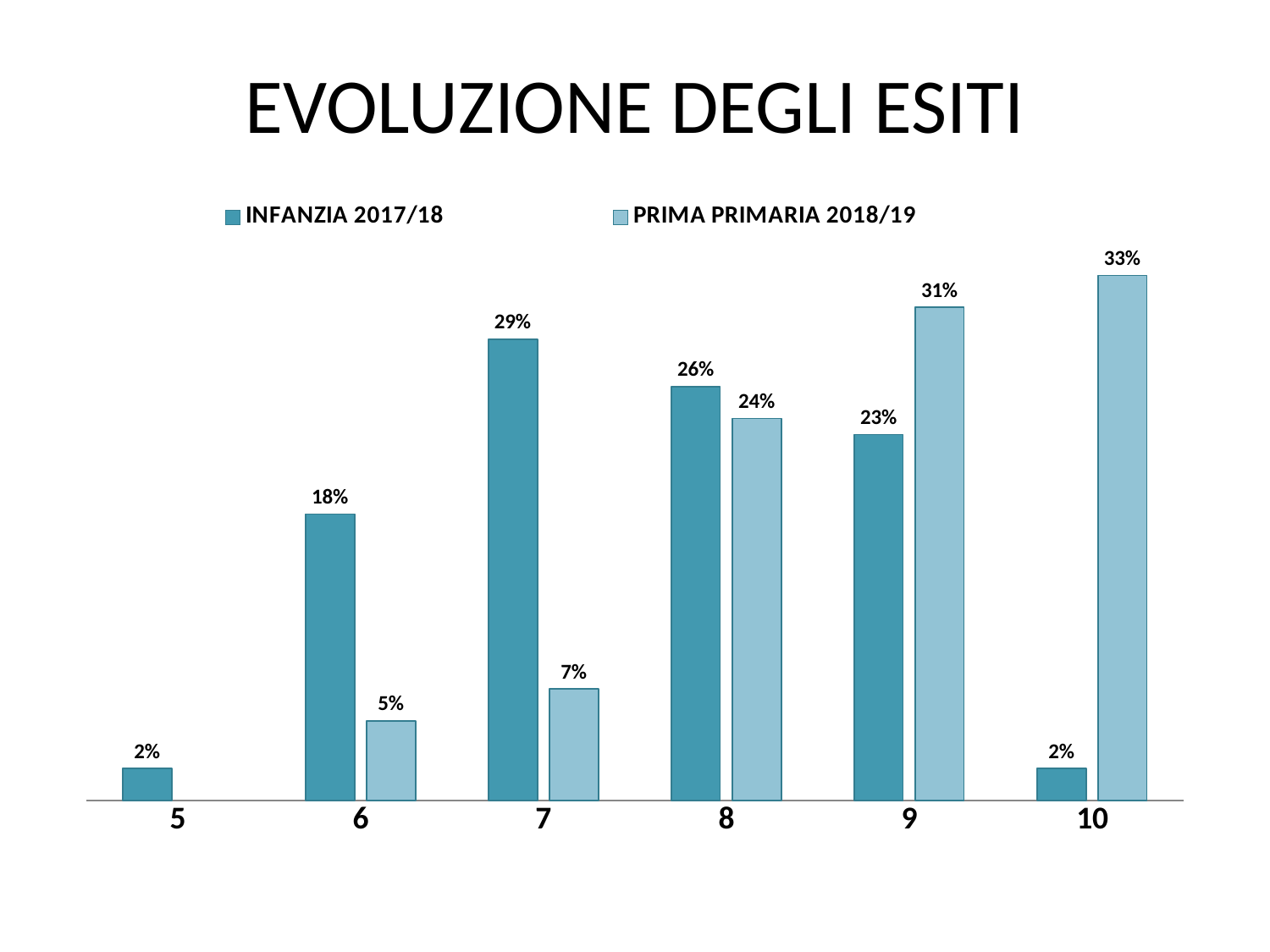
Which category has the highest value for PRIMA PRIMARIA 2018/19? 10 How many categories are shown on the x axis? 6 How many series does the legend list? 2 Which category has the highest value for INFANZIA 2017/18? 7 At category 9, which series has the larger value? PRIMA PRIMARIA 2018/19 What is the value for PRIMA PRIMARIA 2018/19 at category 6? 5% What kind of chart is shown on the slide? Bar chart What is the title of the chart? EVOLUZIONE DEGLI ESITI What is the difference between INFANZIA 2017/18 and PRIMA PRIMARIA 2018/19 at category 7? 22% What is the value for INFANZIA 2017/18 at category 7? 29% What is the value for PRIMA PRIMARIA 2018/19 at category 10? 33% Which category has the lowest value for PRIMA PRIMARIA 2018/19 among those with a bar? 6